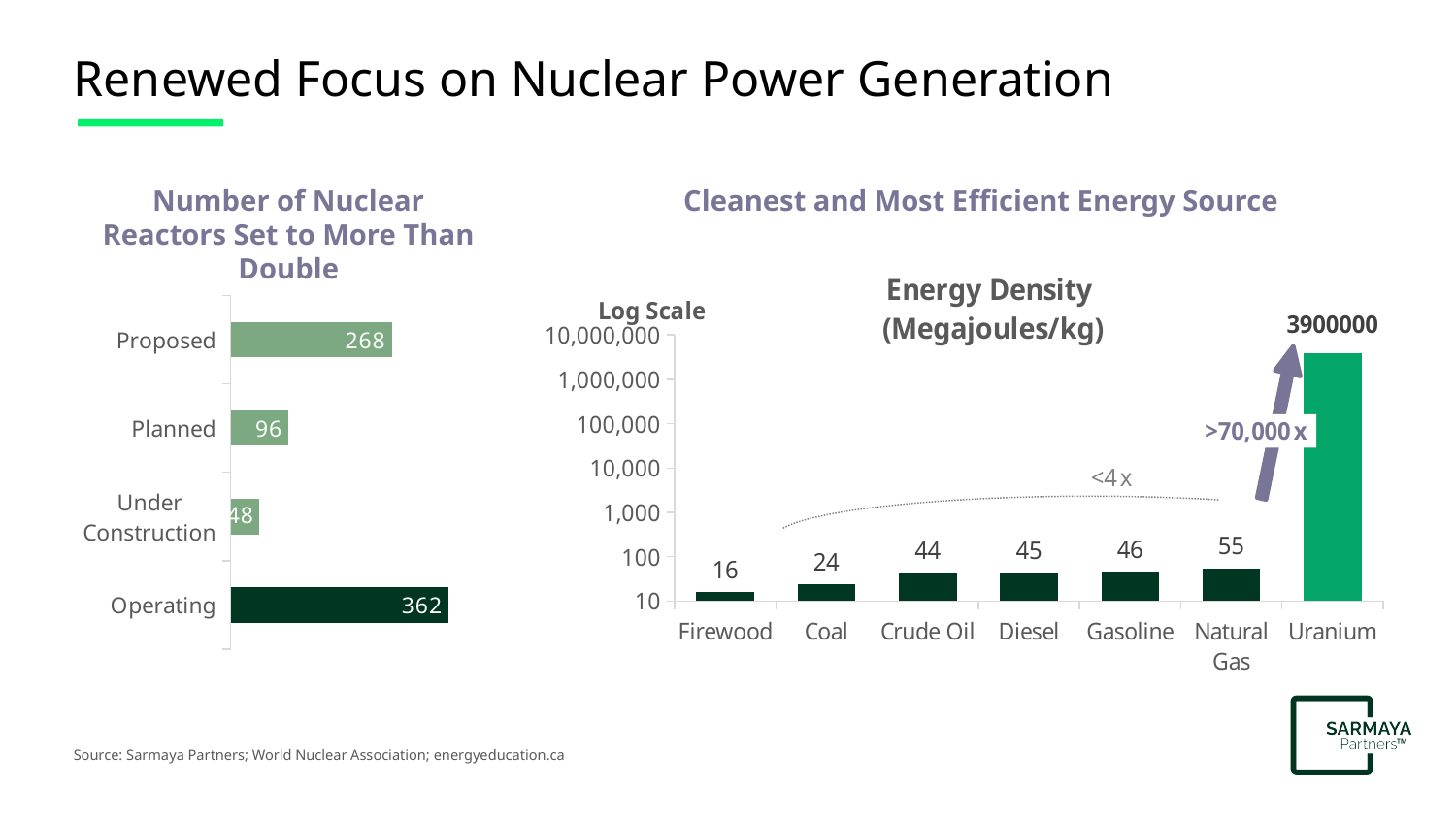
In the 'Number of Nuclear Reactors Set to More Than Double' chart, what is the value for Proposed? 268 In the 'Number of Nuclear Reactors Set to More Than Double' chart, what is the difference between Operating and Proposed? 94 In the 'Energy Density (Megajoules/kg)' chart, which energy source has the lowest energy density? Firewood In the 'Number of Nuclear Reactors Set to More Than Double' chart, how many reactors are Operating? 362 In the 'Number of Nuclear Reactors Set to More Than Double' chart, how many categories are shown? 4 In the 'Energy Density (Megajoules/kg)' chart, which is larger, Coal or Crude Oil? Crude Oil In the 'Number of Nuclear Reactors Set to More Than Double' chart, what is the total of Planned and Under Construction? 144 In the 'Energy Density (Megajoules/kg)' chart, what is the value for Uranium? 3900000 What type of chart is the 'Energy Density (Megajoules/kg)' chart? Bar chart In the 'Energy Density (Megajoules/kg)' chart, how many energy sources are plotted? 7 In the 'Number of Nuclear Reactors Set to More Than Double' chart, which category has the lowest value? Under Construction In the 'Energy Density (Megajoules/kg)' chart, what is the value for Natural Gas? 55